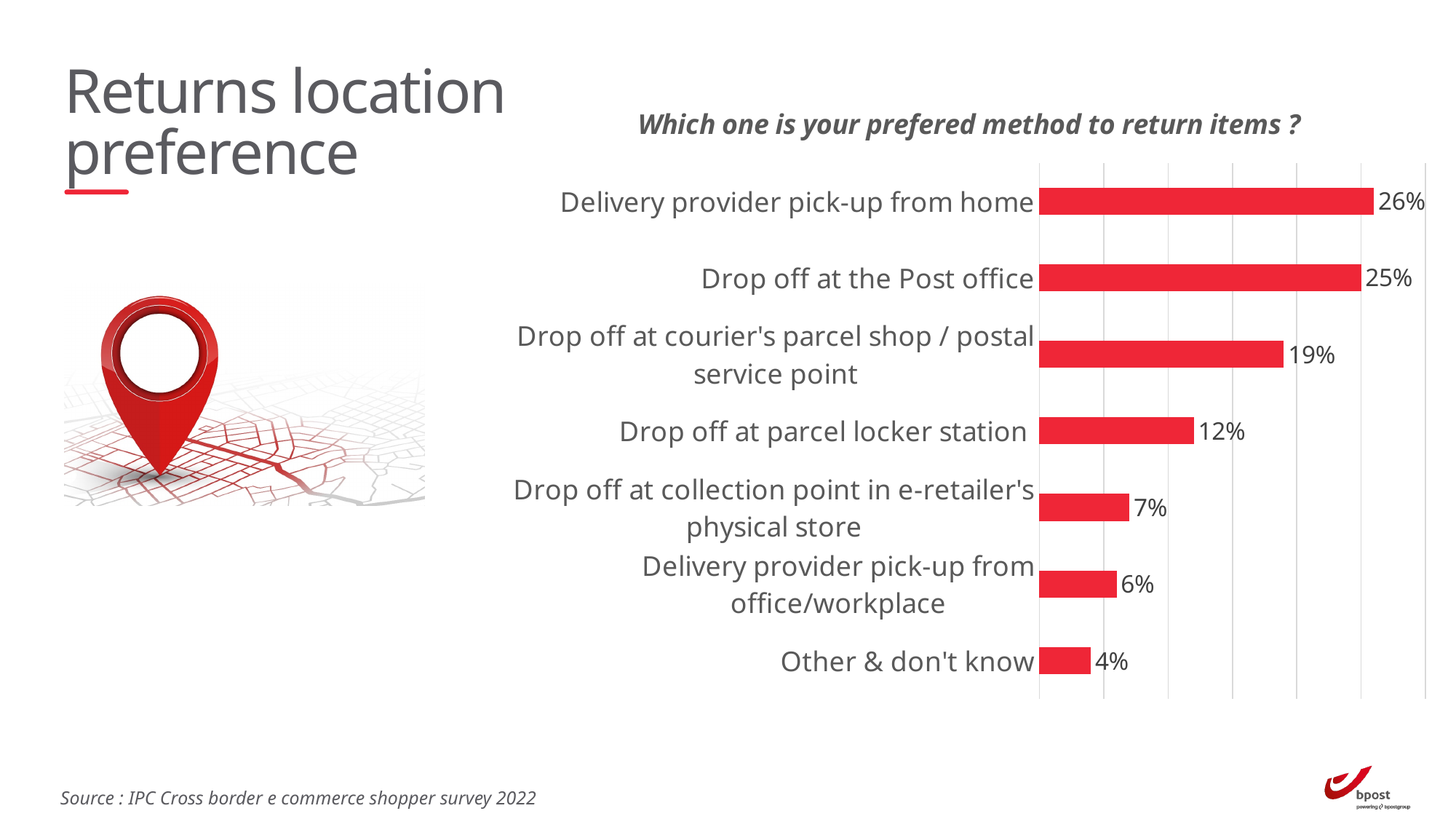
How many categories are shown in the chart? 7 Which is larger: 'Drop off at collection point in e-retailer's physical store' or 'Delivery provider pick-up from office/workplace'? Drop off at collection point in e-retailer's physical store What is the value for 'Drop off at the Post office'? 25% Which category has the lowest value in the chart? Other & don't know What percentage chose 'Other & don't know'? 4% What is the difference between 'Drop off at parcel locker station' and 'Delivery provider pick-up from office/workplace'? 6% What percentage of respondents prefer delivery provider pick-up from home as their method to return items? 26% What is the value shown for 'Drop off at parcel locker station'? 12% What percentage prefer to drop off at a courier's parcel shop / postal service point? 19% Which return method has the highest percentage? Delivery provider pick-up from home What type of chart is shown on the slide? Bar chart What is the difference between 'Delivery provider pick-up from home' and 'Drop off at the Post office'? 1%